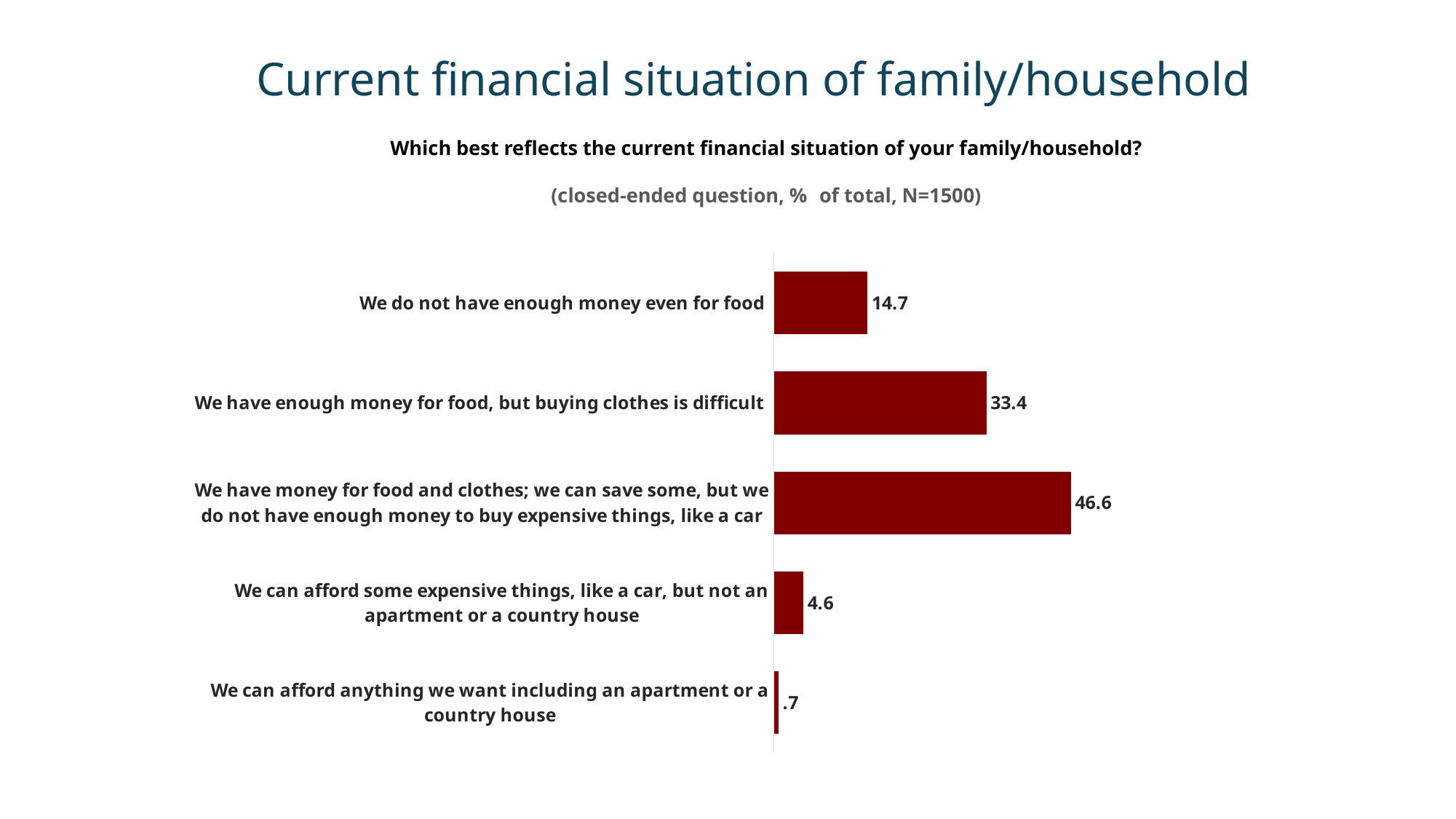
How many response categories are shown in the chart? 5 What is the difference between the value for "We have money for food and clothes; we can save some, but we do not have enough money to buy expensive things, like a car" and the value for "We have enough money for food, but buying clothes is difficult"? 13.2 What is the sample size (N) stated in the chart subtitle? 1500 Which response category has the highest value? We have money for food and clothes; we can save some, but we do not have enough money to buy expensive things, like a car What value is shown for "We have enough money for food, but buying clothes is difficult"? 33.4 What percentage of respondents said "We do not have enough money even for food"? 14.7 What kind of chart is shown on the slide? Bar chart What colour are the bars in the chart? Dark red What value is shown for "We can afford some expensive things, like a car, but not an apartment or a country house"? 4.6 Which response category has the lowest value? We can afford anything we want including an apartment or a country house What value is shown for "We can afford anything we want including an apartment or a country house"? .7 Which is larger: the value for "We do not have enough money even for food" or the value for "We can afford some expensive things, like a car, but not an apartment or a country house"? We do not have enough money even for food